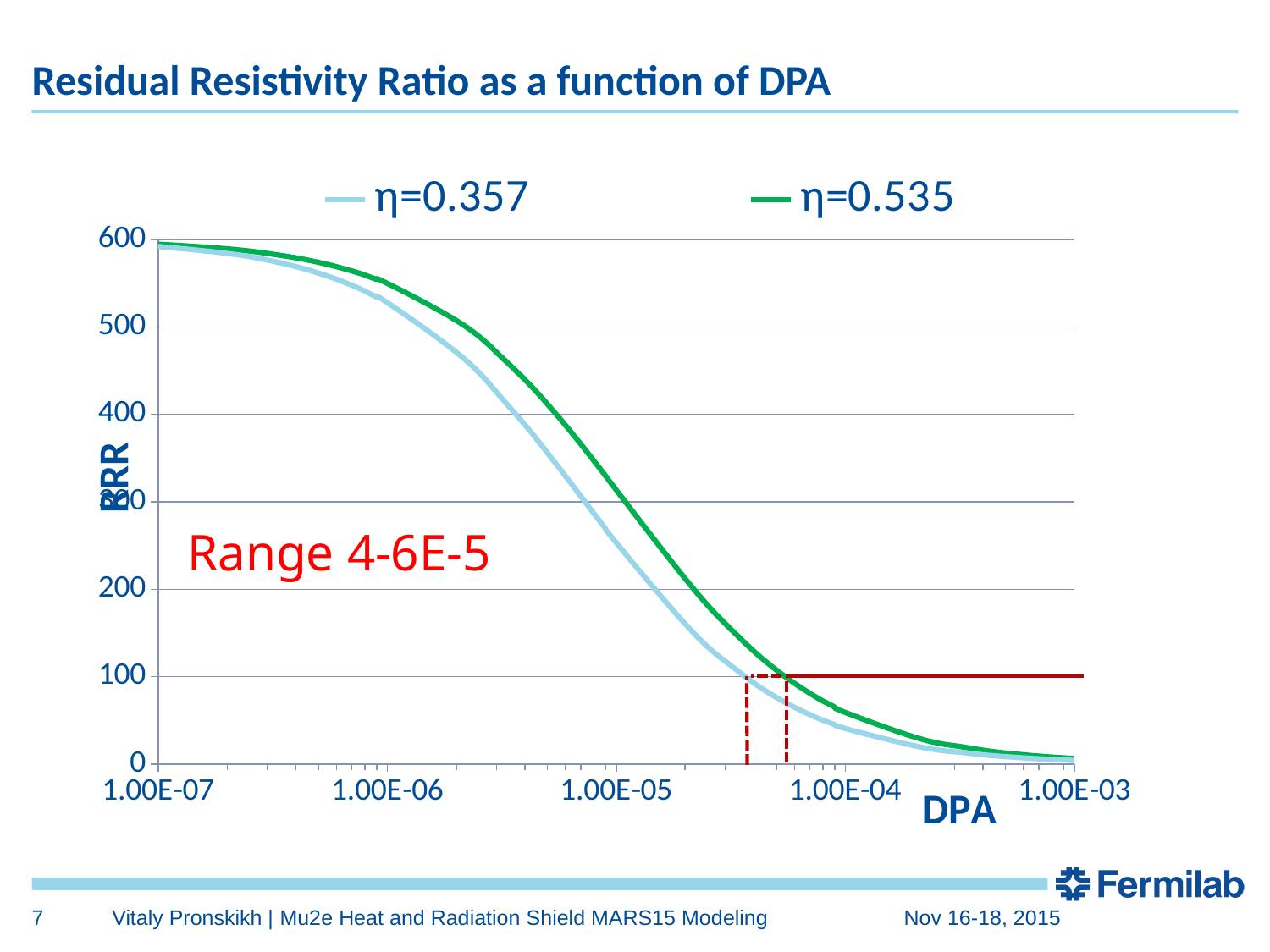
Which series reaches RRR = 100 at the lower DPA value, η=0.357 or η=0.535? η=0.357 Do the RRR values rise or fall as DPA increases along the x axis? fall Is the RRR value for η=0.535 at DPA = 1.00E-04 greater or less than 100? less What kind of chart is shown on the slide? line chart What is the label of the x axis? DPA Is the RRR value for η=0.357 at DPA = 1.00E-06 greater or less than 500? greater How many series does the legend list? 2 Is the RRR value for η=0.357 at DPA = 1.00E-04 greater or less than 100? less What is the title of the chart? Residual Resistivity Ratio as a function of DPA At DPA = 1.00E-05, which series has the higher RRR, η=0.357 or η=0.535? η=0.535